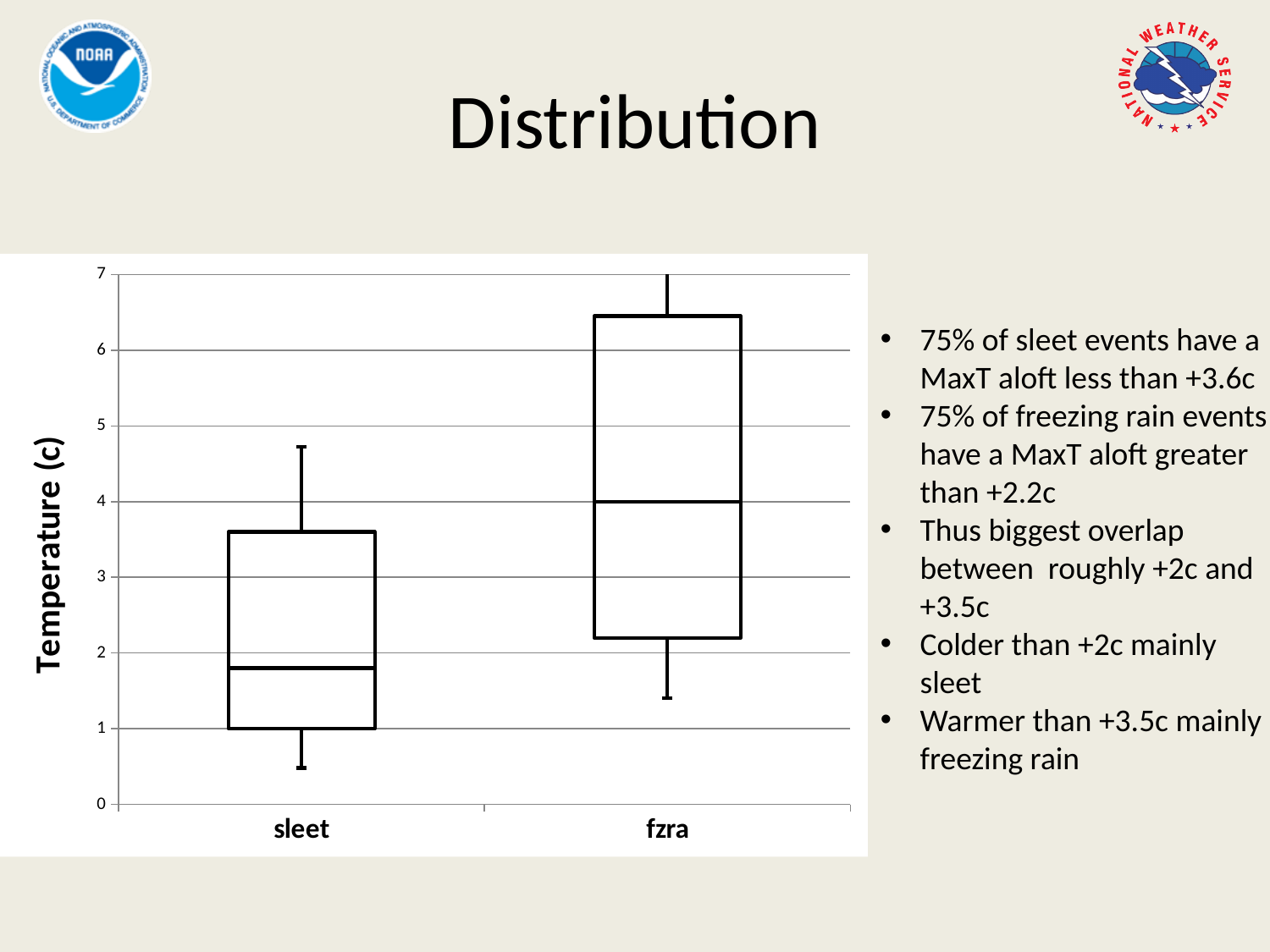
Is the median temperature for sleet greater or less than 2? less Is the upper whisker for sleet greater or less than 4? greater Is the median temperature for fzra greater or less than 3? greater Which category has the higher median temperature, sleet or fzra? fzra How many categories are shown on the x axis of the chart? 2 Which category has the lower minimum (bottom whisker) temperature, sleet or fzra? sleet What kind of chart is shown on the slide? box plot What is the label of the y axis of the chart? Temperature (c) What are the two category labels on the x axis of the chart? sleet and fzra